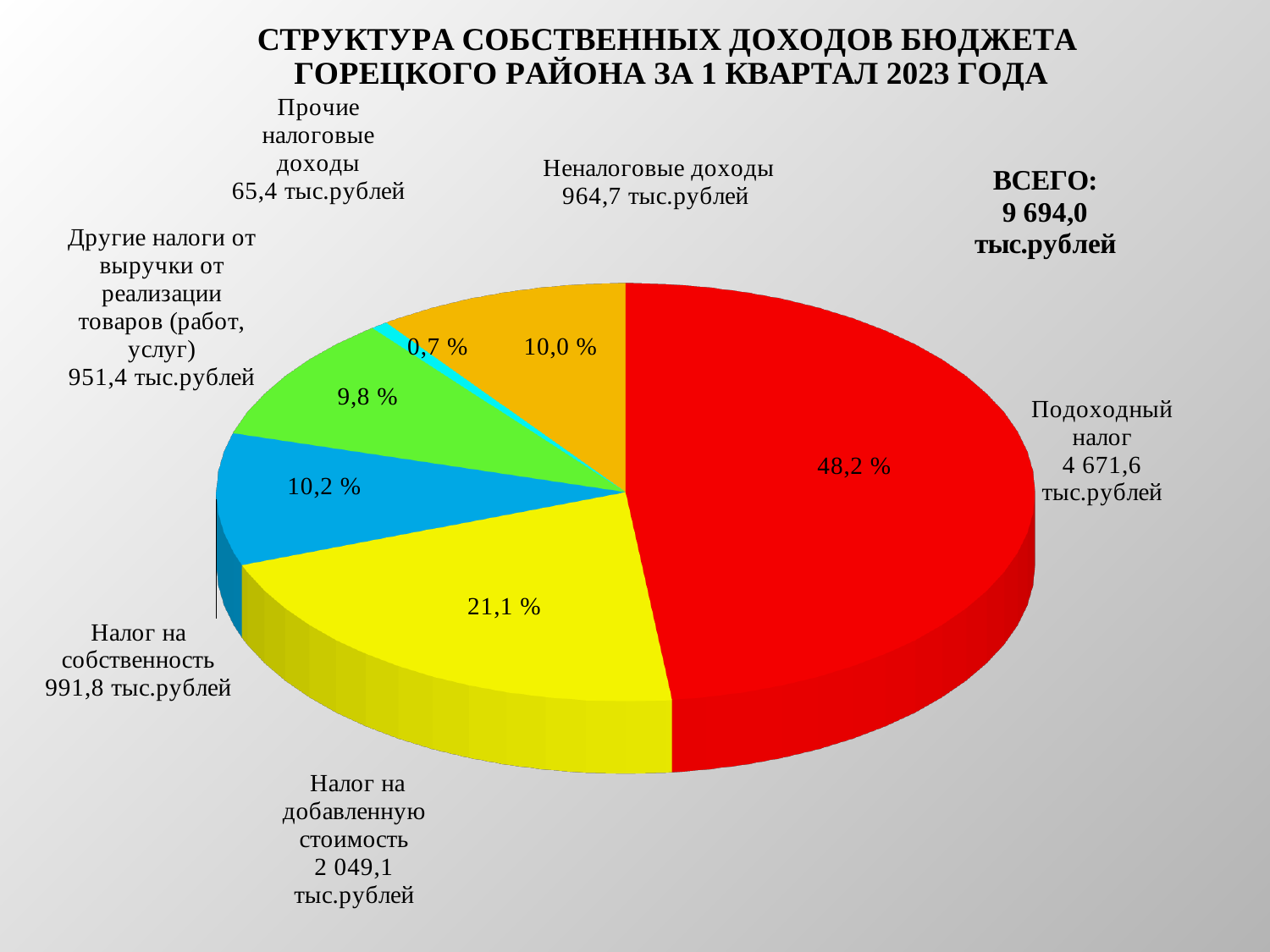
What is the value for Налог на добавленную стоимость? 2 049,1 тыс.рублей Which category has the largest slice of the pie? Подоходный налог What share of the pie does Подоходный налог represent? 48,2 % Which category has the smallest slice of the pie? Прочие налоговые доходы How many slices does the pie chart have? 6 Which is larger: Налог на собственность or Другие налоги от выручки от реализации товаров (работ, услуг)? Налог на собственность What is the value for Подоходный налог? 4 671,6 тыс.рублей What is the difference in percentage points between the Подоходный налог slice (48,2 %) and the Налог на добавленную стоимость slice (21,1 %)? 27,1 % What share of the pie does Налог на собственность represent? 10,2 % What is the value for Неналоговые доходы? 964,7 тыс.рублей What kind of chart is shown on the slide? Pie chart What total (ВСЕГО) is stated on the slide? 9 694,0 тыс.рублей